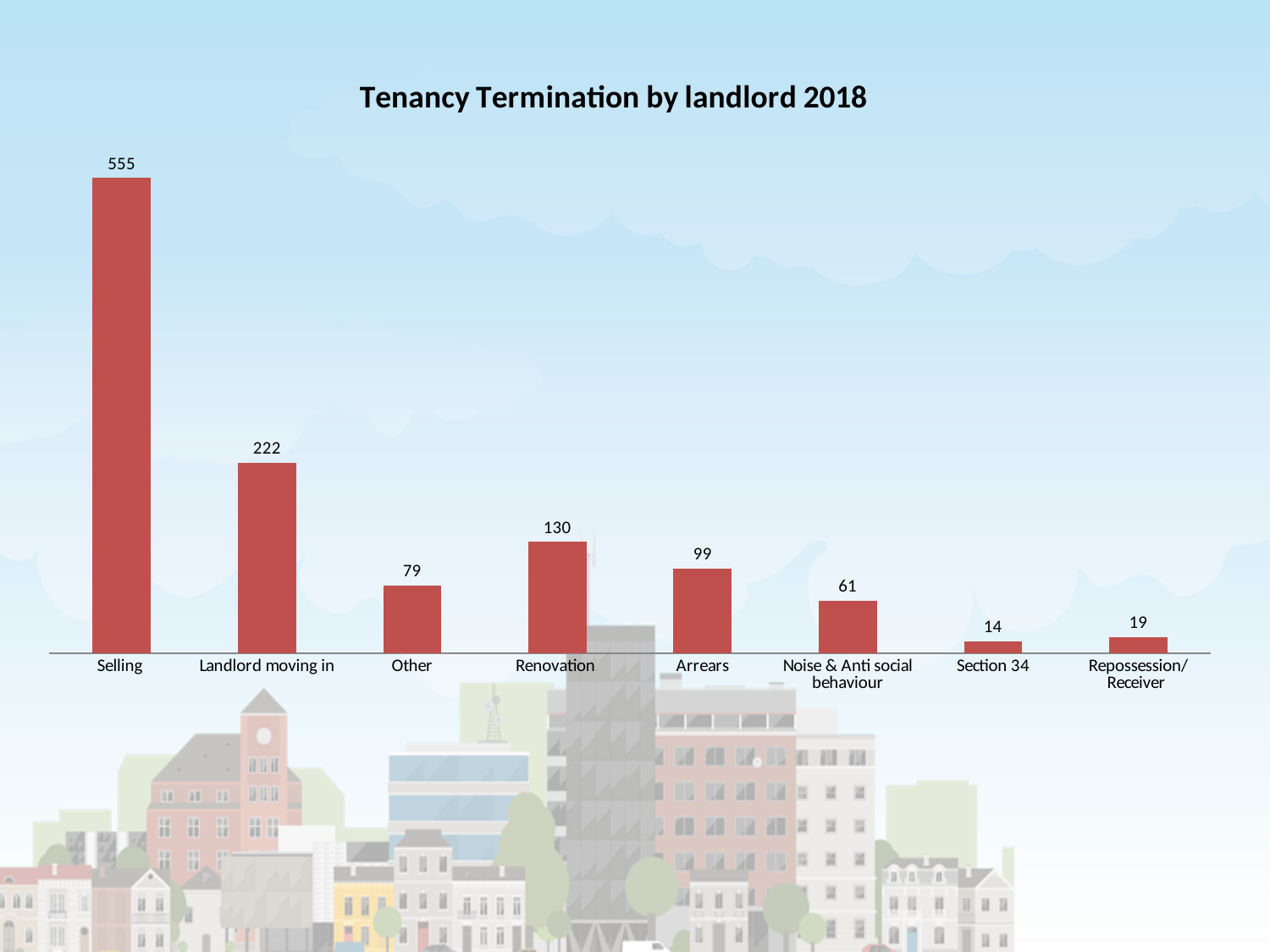
What is the value for Noise & Anti social behaviour? 61 What is the difference between the values for Renovation and Arrears? 31 What is the difference between the values for Selling and Landlord moving in? 333 What is the value for Repossession/ Receiver? 19 How many categories are shown on the chart? 8 What is the value for Landlord moving in? 222 What kind of chart is shown on the slide? Bar chart Which is larger, the value for Other or the value for Renovation? Renovation Which category has the highest value? Selling What is the value for Selling? 555 Which category has the lowest value? Section 34 What is the title of the chart? Tenancy Termination by landlord 2018